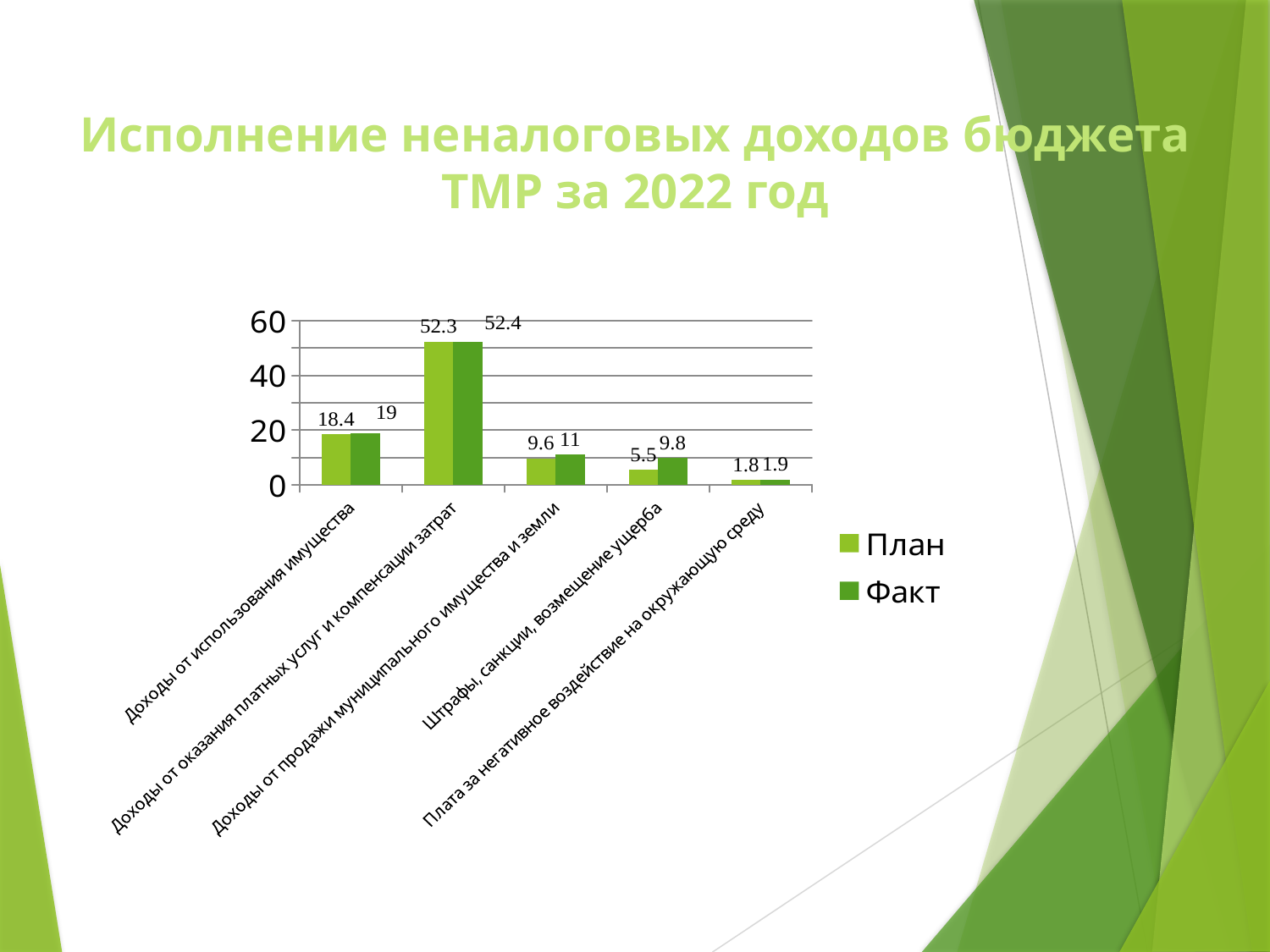
Which is larger for Доходы от продажи муниципального имущества и земли: План or Факт? Факт What kind of chart is shown on the slide? Bar chart What is the difference between the Факт and План values for Штрафы, санкции, возмещение ущерба? 4.3 What is the План value for Плата за негативное воздействие на окружающую среду? 1.8 How many categories are shown on the x axis? 5 What is the План value for Доходы от использования имущества? 18.4 What is the Факт value for Штрафы, санкции, возмещение ущерба? 9.8 Which category has the highest Факт value? Доходы от оказания платных услуг и компенсации затрат What is the Факт value for Доходы от продажи муниципального имущества и земли? 11 Which category has the lowest План value? Плата за негативное воздействие на окружающую среду How many series does the legend list? 2 What is the title of the slide? Исполнение неналоговых доходов бюджета ТМР за 2022 год